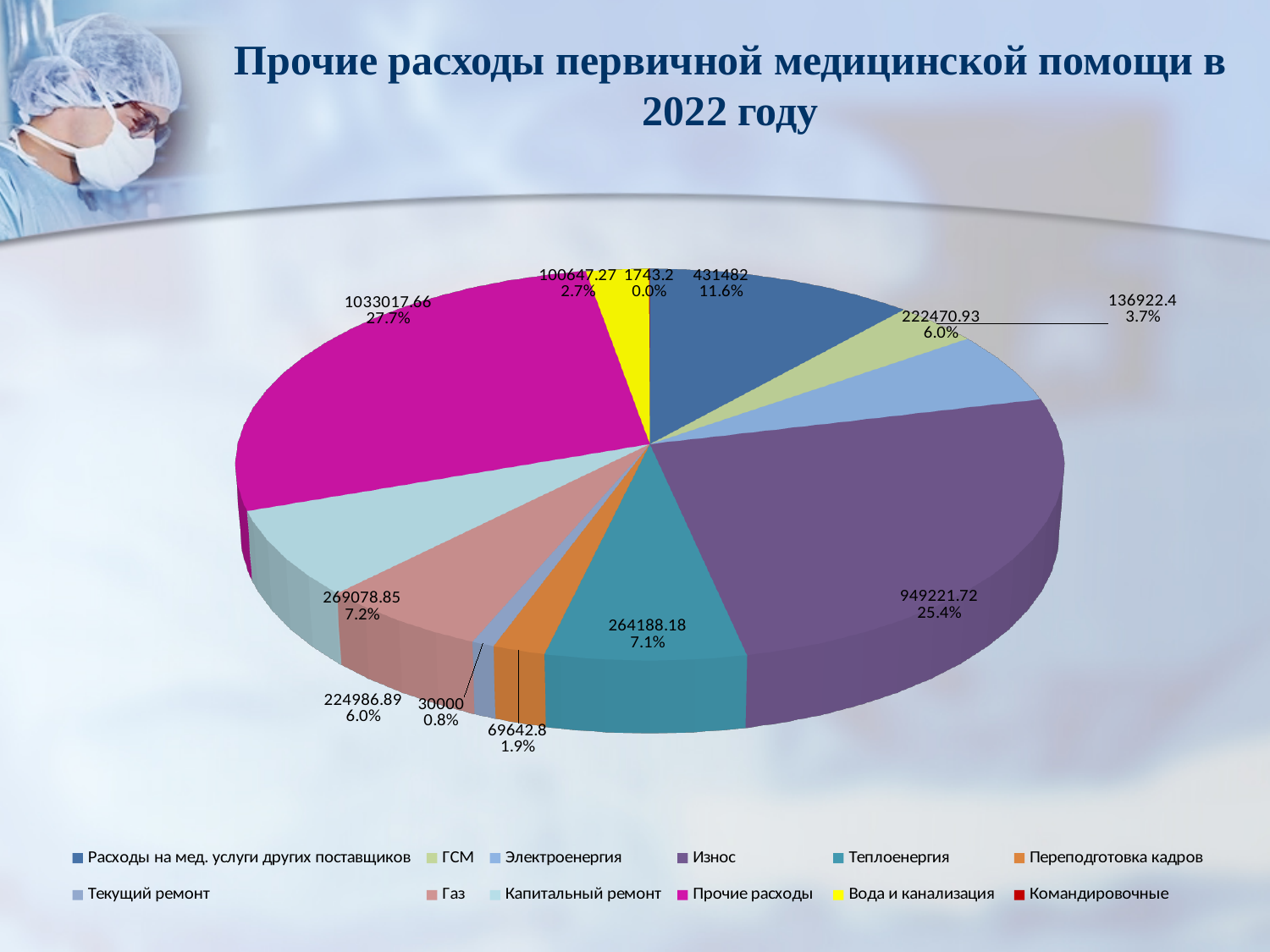
What is the value shown for Прочие расходы? 1033017.66 What is the difference between the values for Капитальный ремонт and Газ? 44091.96 Which is larger, the value for Износ or the value for Расходы на мед. услуги других поставщиков? Износ What kind of chart is shown on the slide? pie chart Which category has the smallest slice of the pie? Командировочные What is the value shown for Износ? 949221.72 How many categories does the legend list? 12 What is the title of the chart? Прочие расходы первичной медицинской помощи в 2022 году What is the value shown for Переподготовка кадров? 69642.8 What percentage share does Вода и канализация have? 2.7% What percentage share does Теплоенергия have? 7.1% Which category has the largest slice of the pie? Прочие расходы